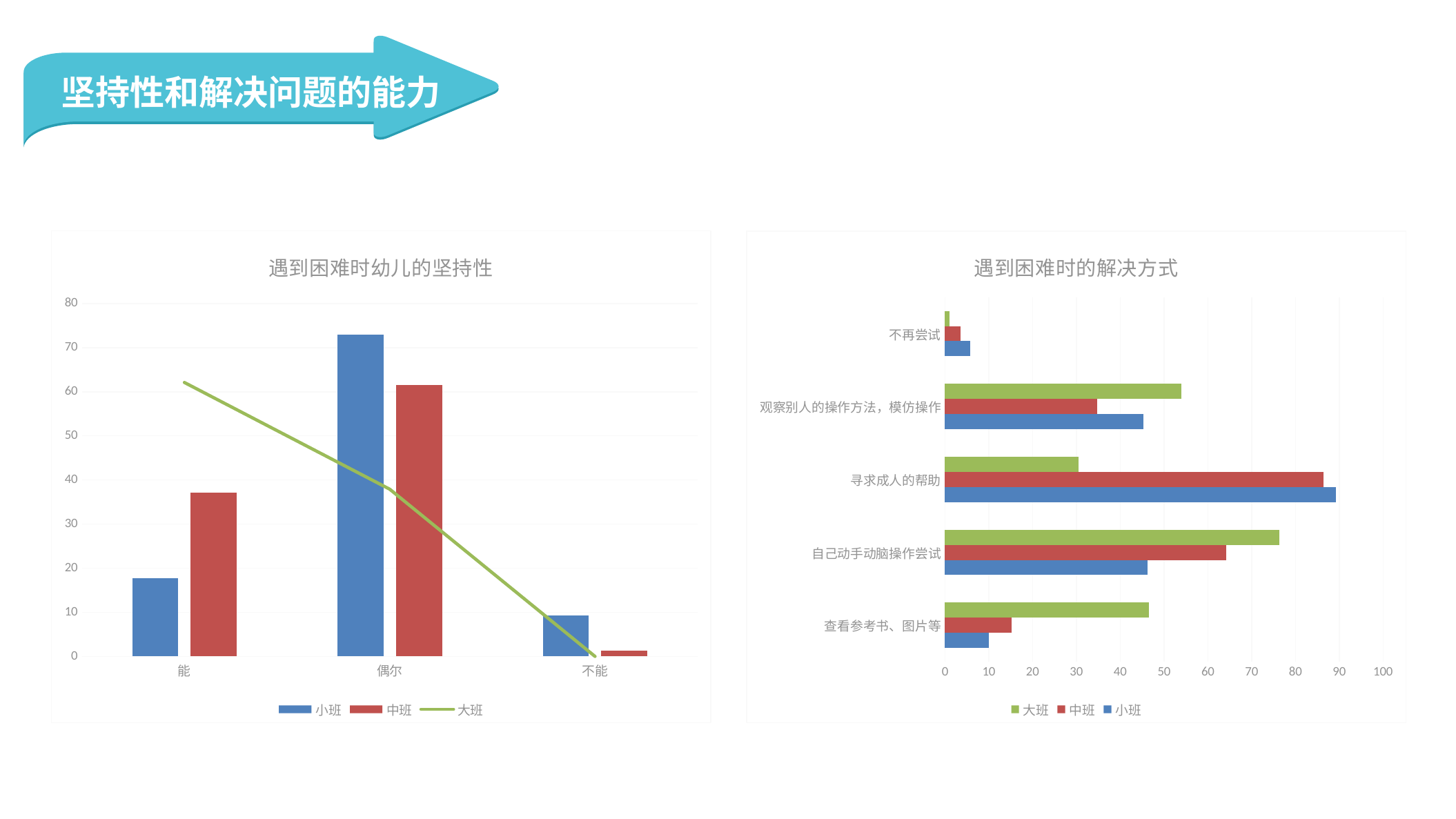
What kind of chart is the right chart titled 遇到困难时的解决方式? bar chart In the chart 遇到困难时幼儿的坚持性, how many categories are shown on the x axis? 3 In the chart 遇到困难时幼儿的坚持性, does the 大班 line rise or fall from 能 to 不能? fall In the chart 遇到困难时幼儿的坚持性, which category has the highest value for 小班? 偶尔 In the chart 遇到困难时幼儿的坚持性, for the category 能, which is larger: 小班 or 中班? 中班 What kind of chart is the left chart titled 遇到困难时幼儿的坚持性? bar chart with a line In the chart 遇到困难时的解决方式, how many categories are shown? 5 In the chart 遇到困难时的解决方式, which category has the highest value for 大班? 自己动手动脑操作尝试 In the chart 遇到困难时的解决方式, for 查看参考书、图片等, which is larger: 大班 or 中班? 大班 In the chart 遇到困难时幼儿的坚持性, is the value for 小班 at 偶尔 greater or less than 70? greater In the chart 遇到困难时幼儿的坚持性, how many series does the legend list? 3 In the chart 遇到困难时的解决方式, is the value for 小班 at 寻求成人的帮助 greater or less than 80? greater